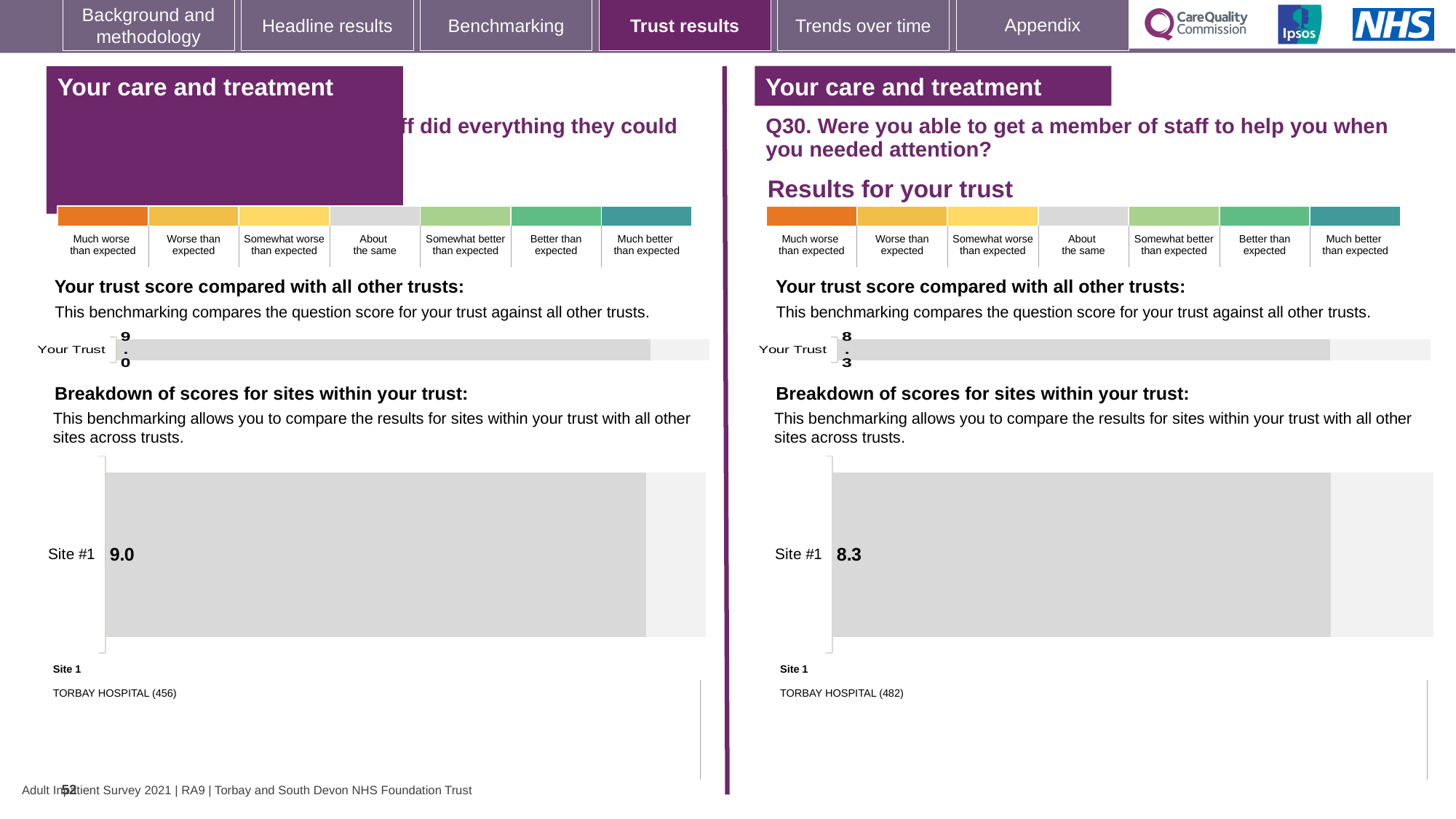
On the left-hand side of the slide, what is the score shown for Your Trust in the 'Your trust score compared with all other trusts' chart? 9.0 On the left-hand side of the slide, what is the score for Site #1 in the 'Breakdown of scores for sites within your trust' chart? 9.0 What type of chart is used to show the Your Trust score on the left-hand side of the slide? Bar chart Which is larger: the Your Trust score on the left-hand chart or the Your Trust score on the right-hand (Q30) chart? The left-hand chart On the right-hand side of the slide (Q30), what is the score shown for Your Trust in the 'Your trust score compared with all other trusts' chart? 8.3 On the right-hand side of the slide (Q30), what is the score for Site #1 in the 'Breakdown of scores for sites within your trust' chart? 8.3 On the right-hand side of the slide (Q30), which hospital is listed as Site 1 below the site breakdown chart? TORBAY HOSPITAL (482) What is the difference between the Site #1 score on the left-hand chart and the Site #1 score on the right-hand (Q30) chart? 0.7 How many sites are shown in the right-hand (Q30) 'Breakdown of scores for sites within your trust' chart? 1 On the left-hand side of the slide, which hospital is listed as Site 1 below the site breakdown chart? TORBAY HOSPITAL (456) What type of chart is used for the 'Breakdown of scores for sites within your trust' on the right-hand side (Q30)? Bar chart How many sites are shown in the left-hand 'Breakdown of scores for sites within your trust' chart? 1